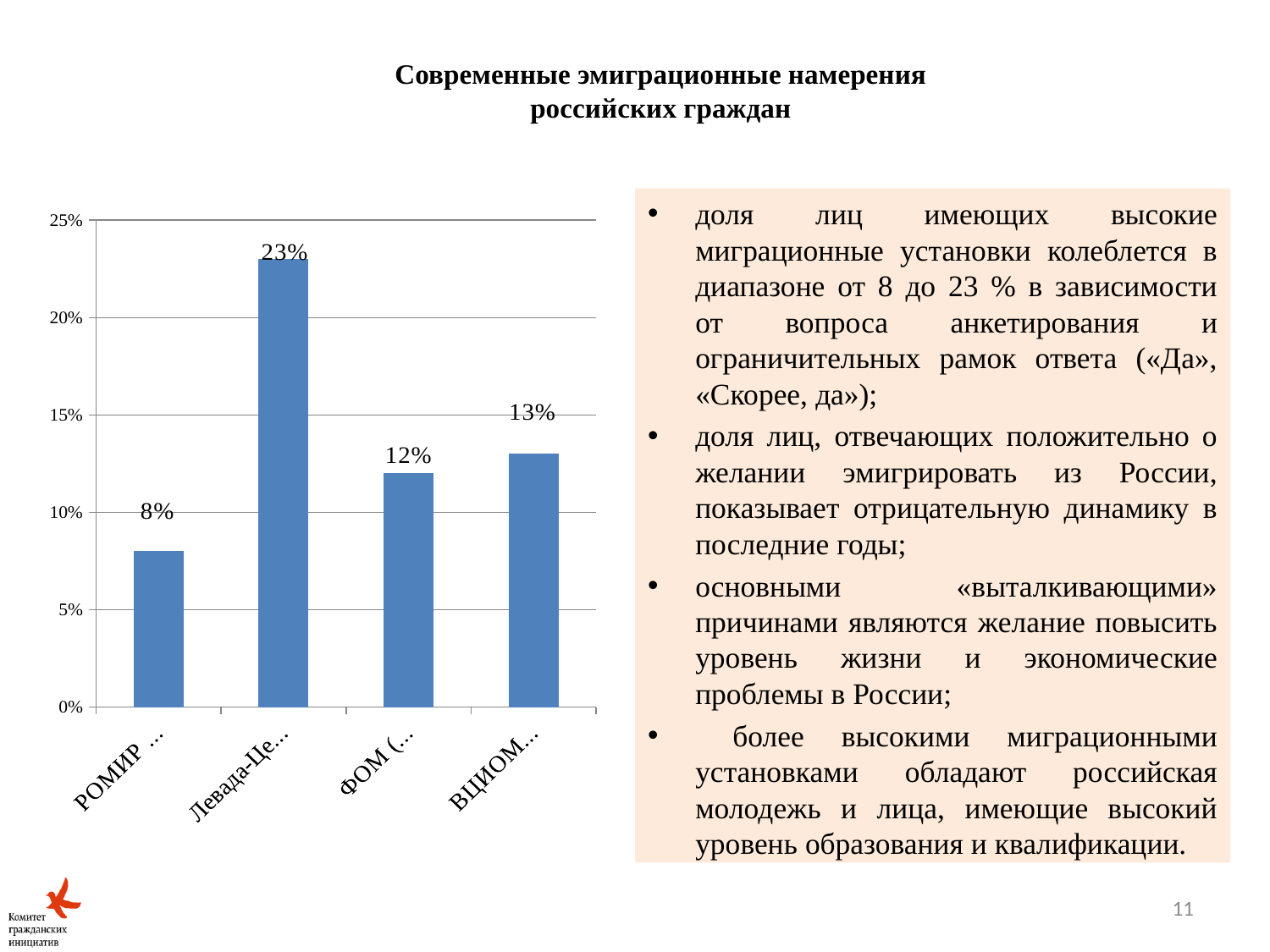
What is the difference between the ВЦИОМ value and the ФОМ value? 1% What kind of chart is shown on the slide? bar chart What is the difference between the Левада-Це... value and the РОМИР value? 15% What is the value for ВЦИОМ? 13% Which category has the lowest value? РОМИР What is the value for ФОМ? 12% Which category has the highest value? Левада-Це... What is the value for the Левада-Це... bar? 23% Which is larger, the value for ФОМ or the value for РОМИР? ФОМ What is the value for РОМИР? 8% Is the value for Левада-Це... greater or less than 20%? greater How many bars are shown in the chart? 4